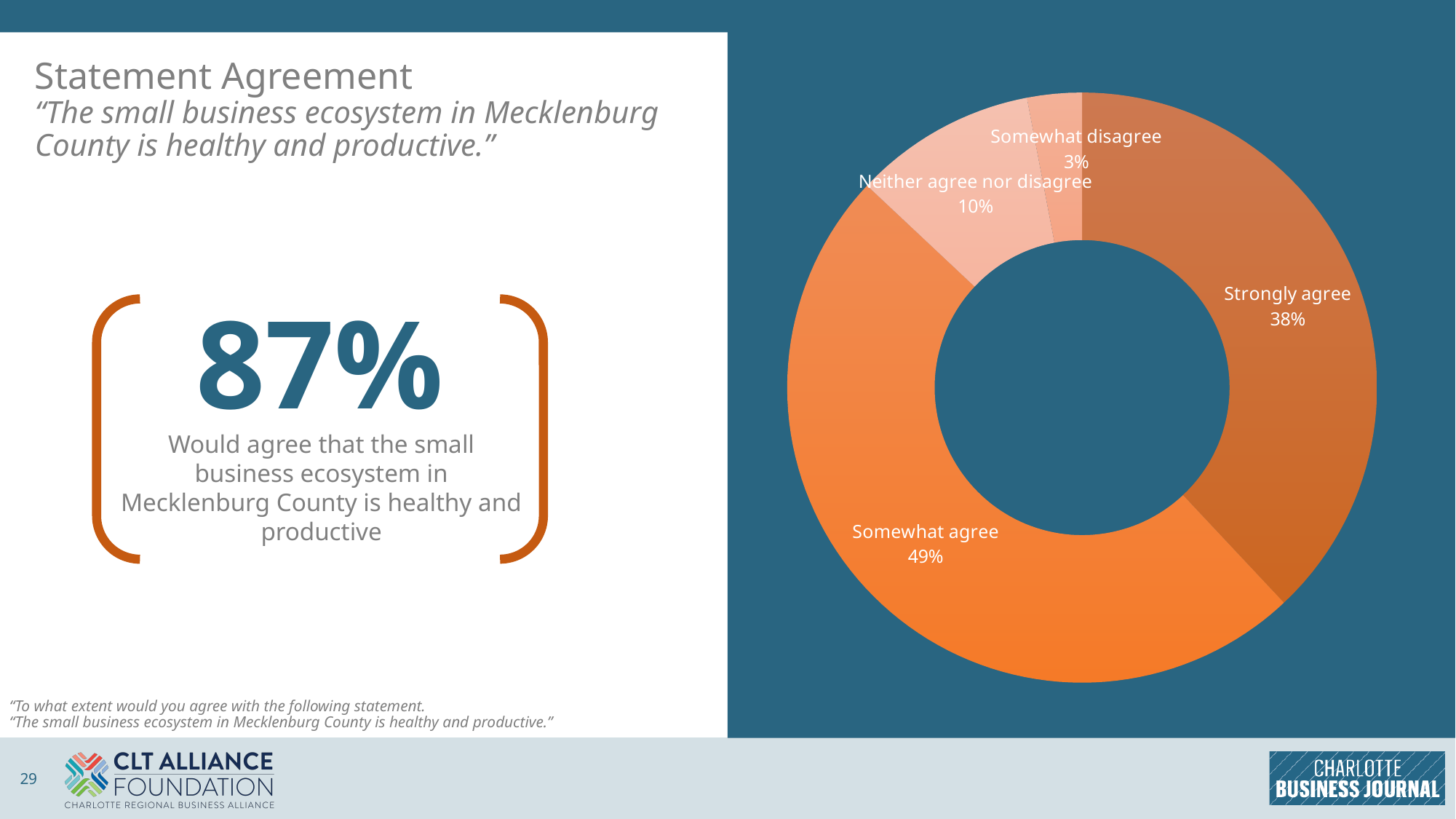
What kind of chart is used to show the statement agreement responses? Donut (pie) chart What is the title of the chart section on the slide? Statement Agreement How many response categories are shown in the donut chart? 4 What is the combined share of Strongly agree and Somewhat agree? 87% Which response category has the largest share of the donut chart? Somewhat agree What is the difference in percentage points between Somewhat agree and Strongly agree? 11 What share of respondents neither agree nor disagree? 10% Which response category has the smallest share of the donut chart? Somewhat disagree What percentage of respondents strongly agree that the small business ecosystem in Mecklenburg County is healthy and productive? 38% What percentage of respondents somewhat disagree with the statement? 3% Which is larger: the share for Neither agree nor disagree or the share for Somewhat disagree? Neither agree nor disagree What percentage of respondents somewhat agree with the statement? 49%